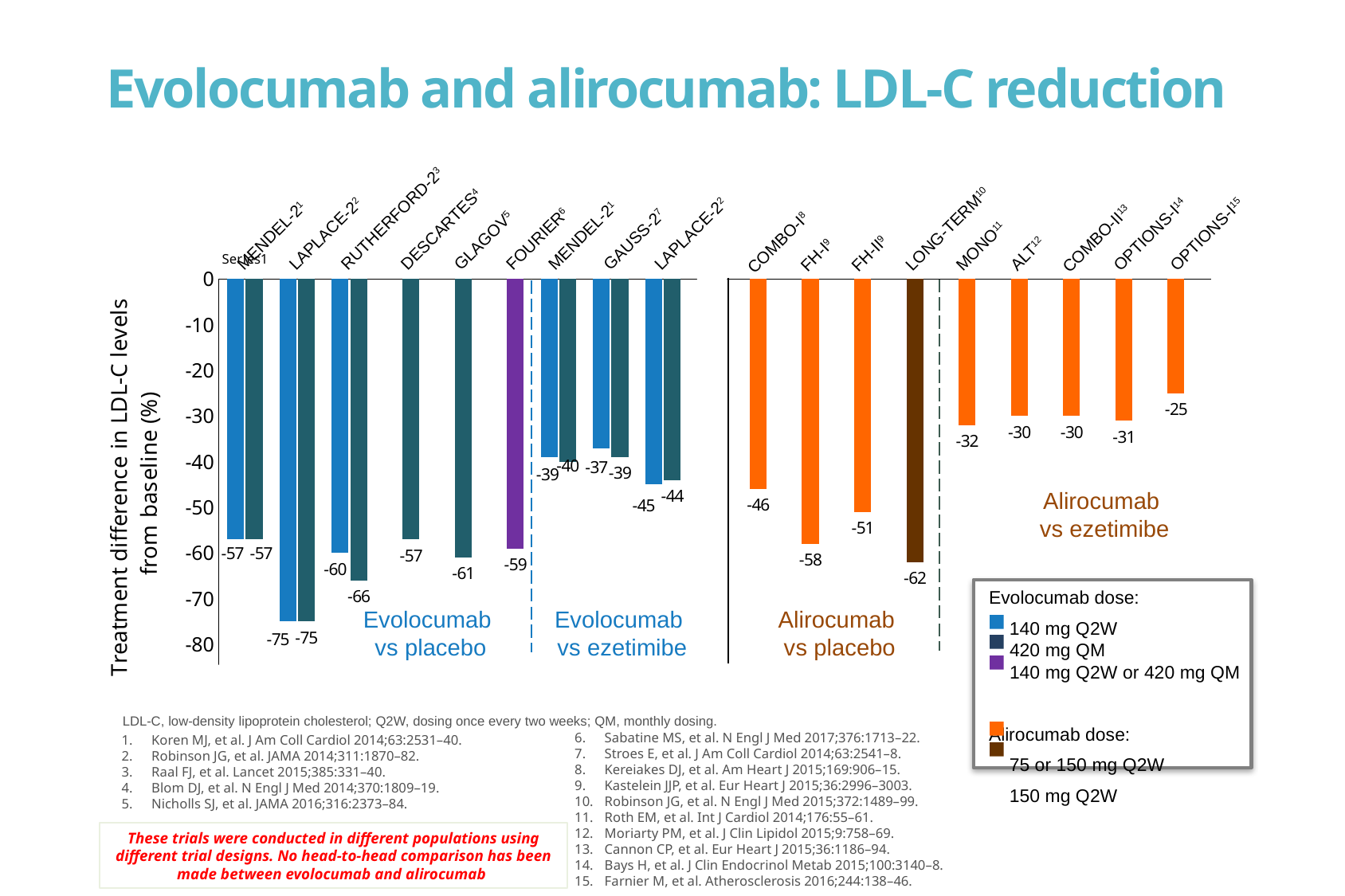
What is the treatment difference in LDL-C levels for the OPTIONS-II trial? -25 Which trial shows a larger LDL-C reduction, MONO or OPTIONS-II? MONO What is the treatment difference in LDL-C levels for the COMBO-I trial? -46 What is the treatment difference in LDL-C levels for the LONG-TERM trial? -62 What is the difference between the LDL-C treatment difference for FH-I and FH-II? 7 Which trial shows a larger LDL-C reduction, GLAGOV or DESCARTES? GLAGOV Which trial shows the largest LDL-C reduction (most negative value) on the chart? LAPLACE-2 (-75) According to the legend, which evolocumab dose is represented by the purple bar? 140 mg Q2W or 420 mg QM What is the treatment difference in LDL-C levels for the FOURIER trial? -59 What kind of chart is shown on the slide? Bar chart Which trial shows the smallest LDL-C reduction (least negative value) on the chart? OPTIONS-II (-25) How many trials are shown in the 'Alirocumab vs ezetimibe' section of the chart? 5